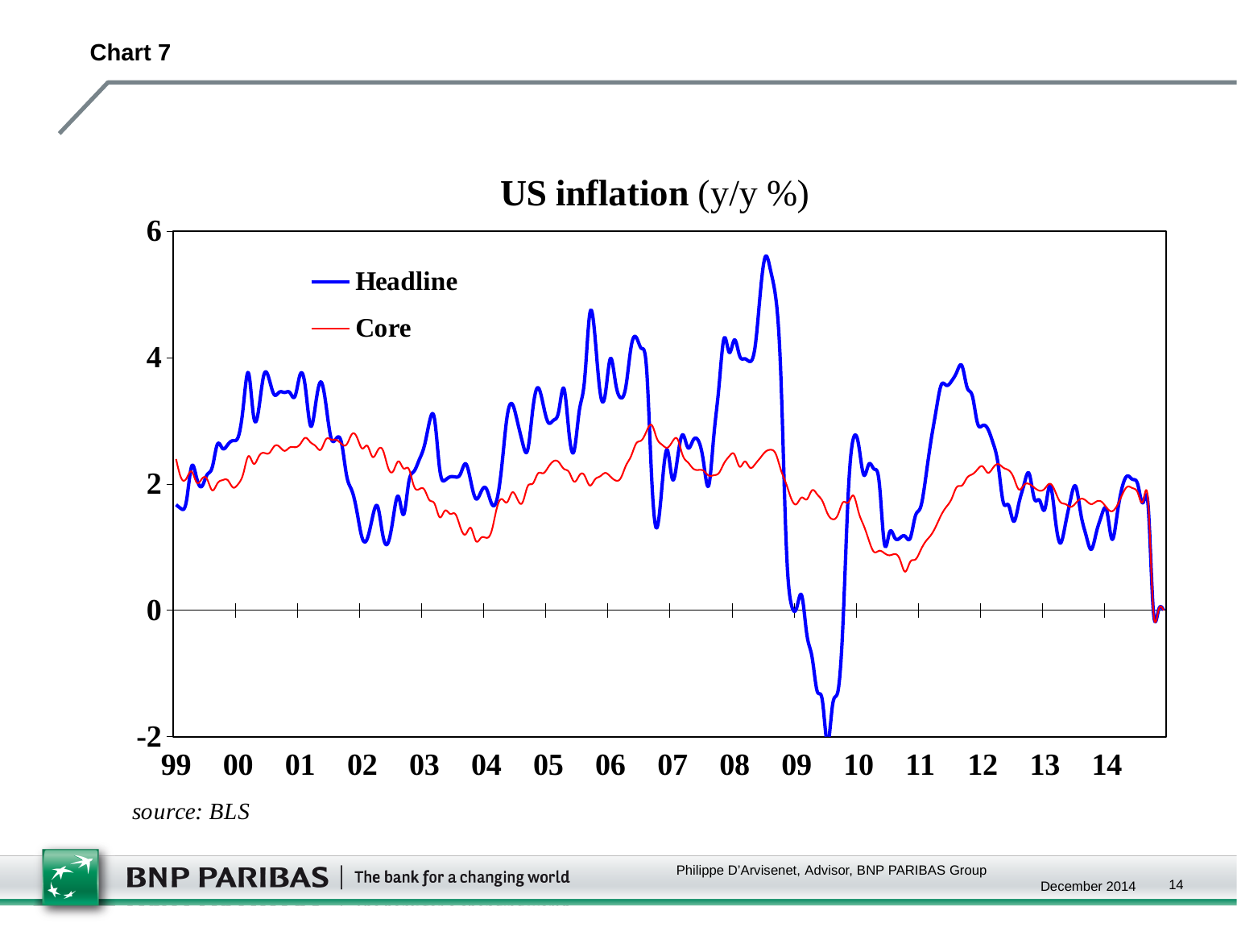
In mid-2009, which series is higher, Headline or Core? Core Is the Core series ever greater or less than 4 over the whole period? less Is the peak value of the Headline series in 2008 greater or less than 4? greater Which series reaches the highest value on the chart? Headline Which series reaches the lowest value on the chart? Headline What is the title of the chart? US inflation (y/y %) At the 2008 peak, which series is higher, Headline or Core? Headline How many series does the legend list? 2 What kind of chart is shown on the slide? line chart Is the lowest value of the Headline series in 2009 greater or less than 0? less Does the Headline series rise or fall from its 2011 peak to the end of 2014? fall What are the two series named in the legend? Headline and Core